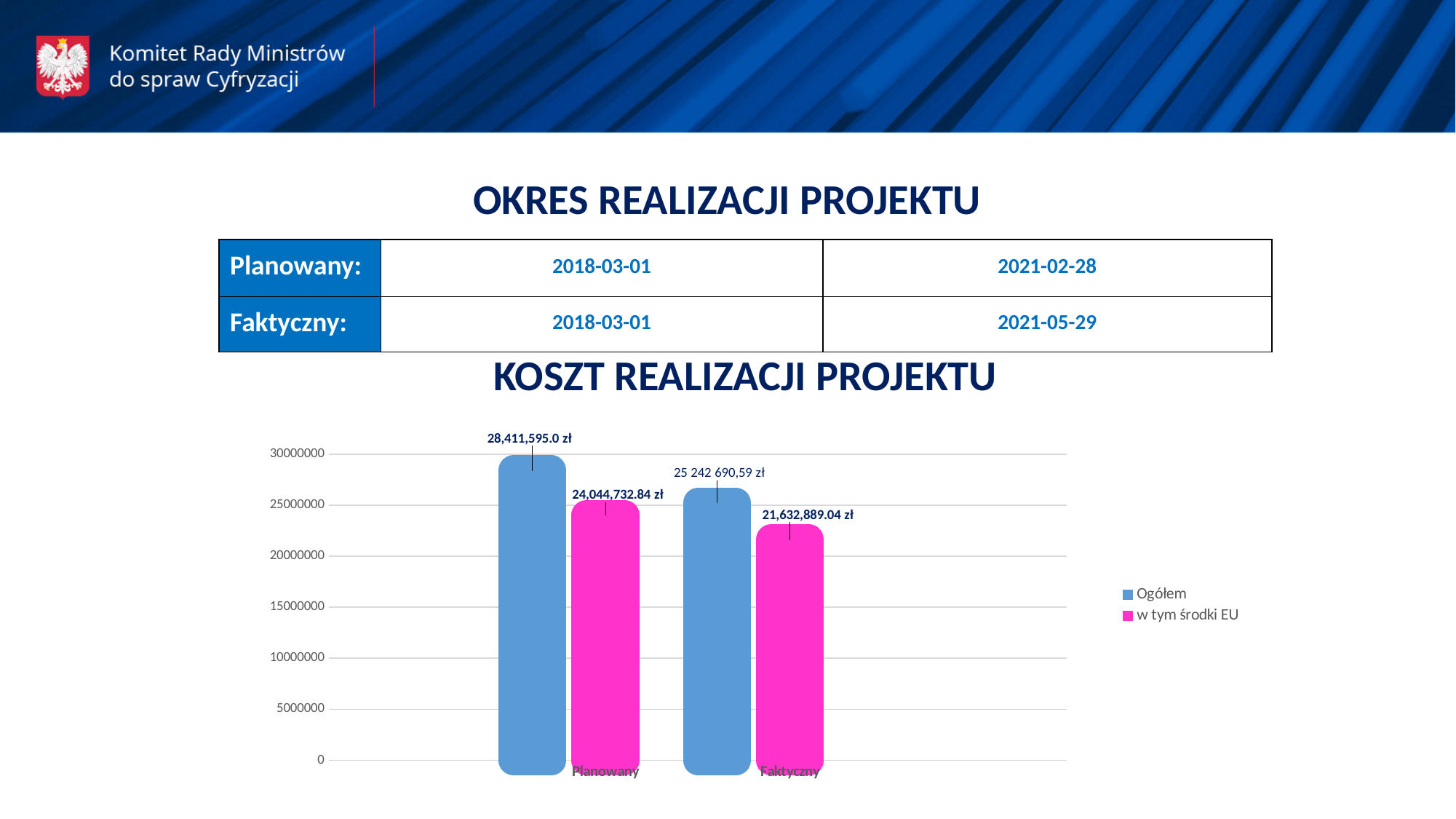
What is the value of Ogółem for Planowany in the KOSZT REALIZACJI PROJEKTU chart? 28,411,595.0 zł What is the value of w tym środki EU for Faktyczny in the KOSZT REALIZACJI PROJEKTU chart? 21,632,889.04 zł What is the value of w tym środki EU for Planowany in the KOSZT REALIZACJI PROJEKTU chart? 24,044,732.84 zł What type of chart is the KOSZT REALIZACJI PROJEKTU chart? Bar chart In the KOSZT REALIZACJI PROJEKTU chart, what is the difference between Ogółem and w tym środki EU for Planowany? 4,366,862.16 zł In the KOSZT REALIZACJI PROJEKTU chart, what is the difference between Ogółem and w tym środki EU for Faktyczny? 3,609,801.55 zł What is the value of Ogółem for Faktyczny in the KOSZT REALIZACJI PROJEKTU chart? 25 242 690,59 zł Which bar in the KOSZT REALIZACJI PROJEKTU chart has the lowest value? w tym środki EU for Faktyczny Which bar in the KOSZT REALIZACJI PROJEKTU chart has the highest value? Ogółem for Planowany How many categories are shown on the x axis of the KOSZT REALIZACJI PROJEKTU chart? 2 How many series does the legend of the KOSZT REALIZACJI PROJEKTU chart list? 2 In the KOSZT REALIZACJI PROJEKTU chart, is the Ogółem value larger for Planowany or for Faktyczny? Planowany